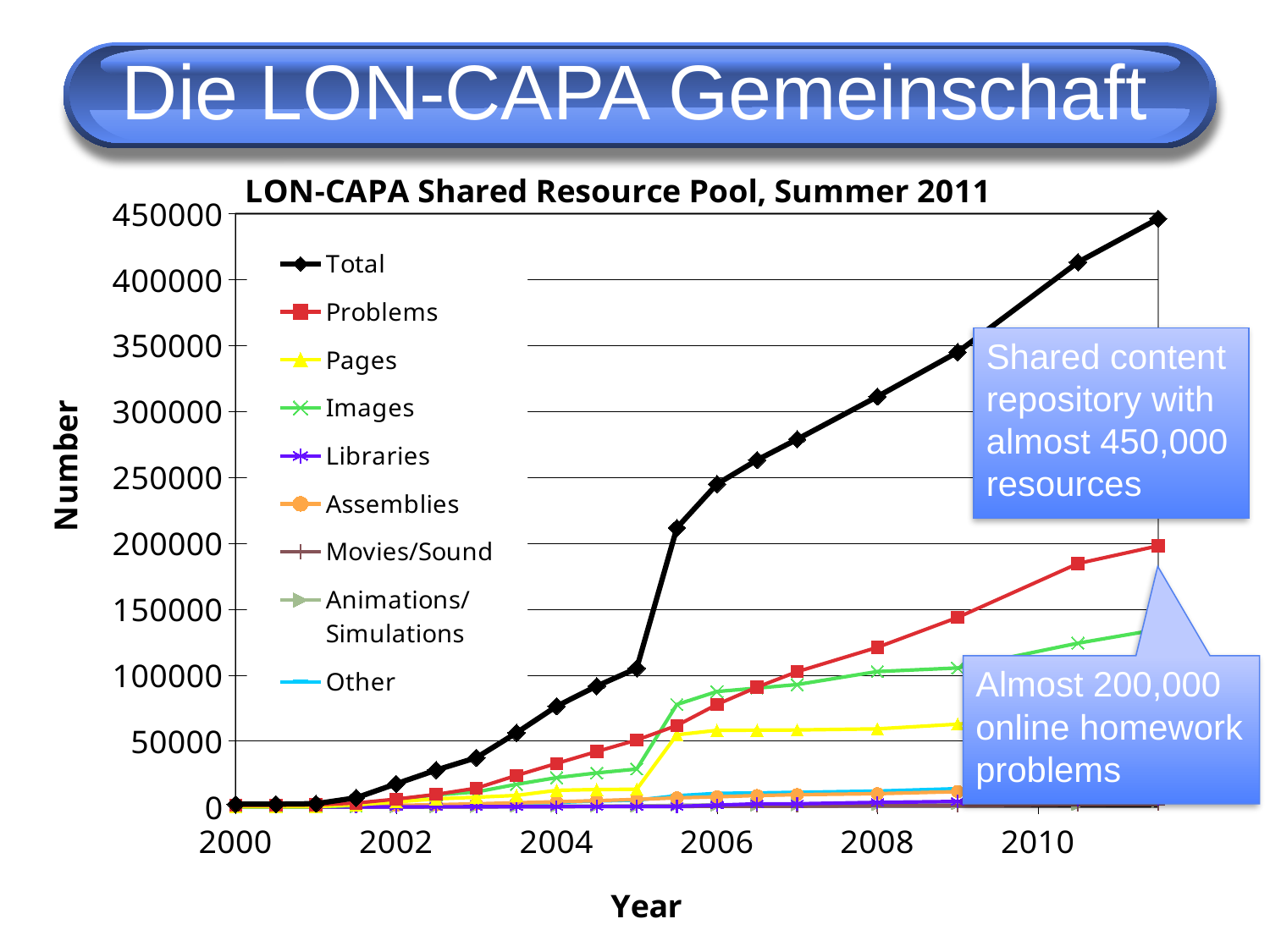
In 2008, which is larger: Pages or Images? Images Does the Total series rise or fall from 2000 to 2011? rise Which series has the highest value at the end of the chart? Total How many series does the chart's legend list? 9 What is the label of the chart's vertical axis? Number Excluding Total, which series has the highest value in 2010? Problems What kind of chart is shown on the slide? line chart Is the value of Images in 2010 greater or less than 100000? greater What is the title of the chart? LON-CAPA Shared Resource Pool, Summer 2011 Is the value of Problems in 2010 greater or less than 150000? greater Is the value of Total in 2007 greater or less than 250000? greater